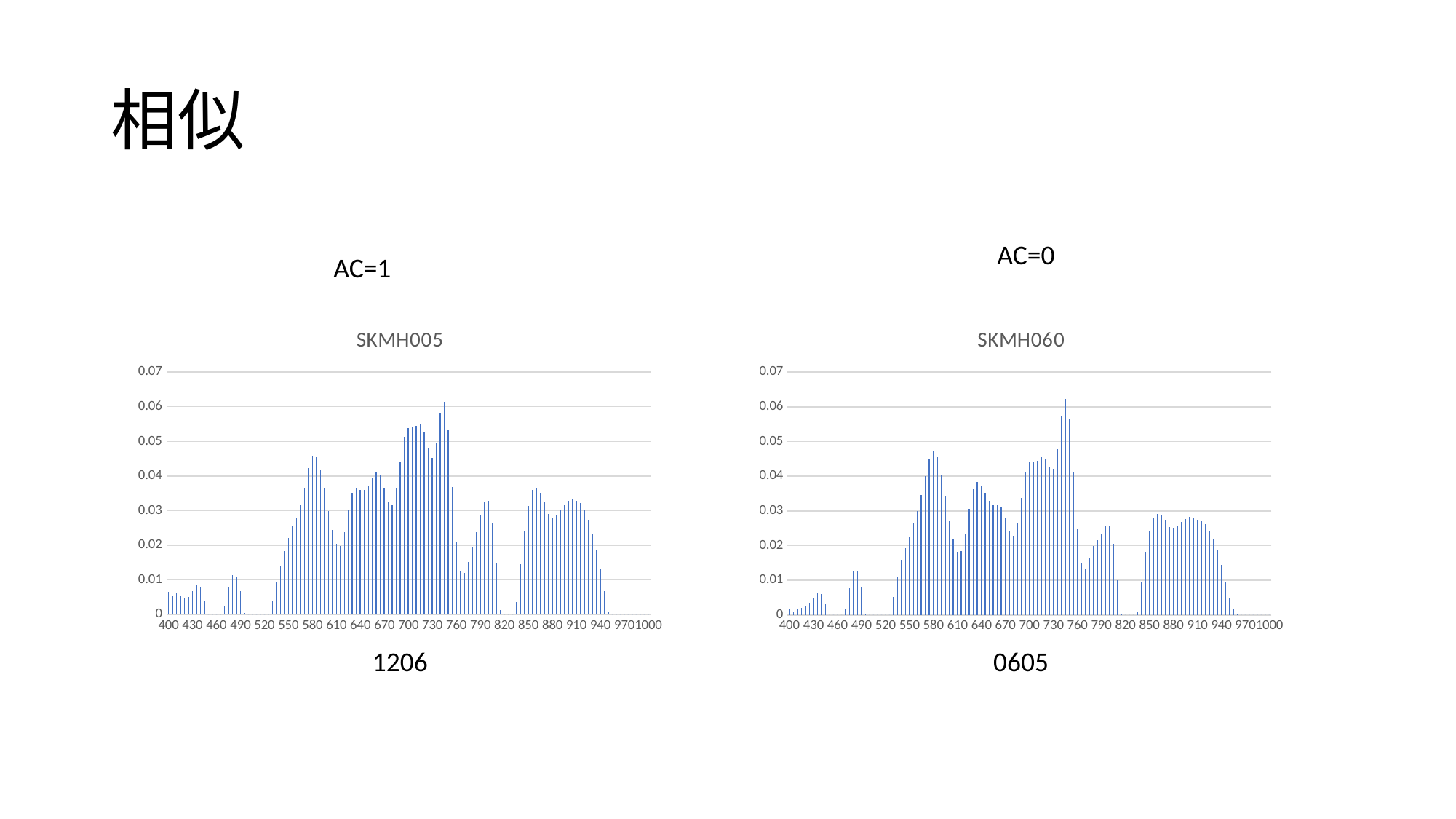
In the SKMH005 chart, is the value at 820 greater or less than 0.01? less In the SKMH060 chart, what is the first label on the x axis? 400 What is the title of the chart on the left? SKMH005 In the SKMH060 chart, is the value at 850 greater or less than 0.02? greater How many charts are shown on the slide? 2 In the SKMH060 chart, is the tallest bar greater or less than 0.05? greater What is the title of the chart on the right? SKMH060 In the SKMH060 chart, what is the last label on the x axis? 1000 In the SKMH005 chart, what is the highest value shown on the y axis? 0.07 What kind of chart is the SKMH005 chart? bar chart